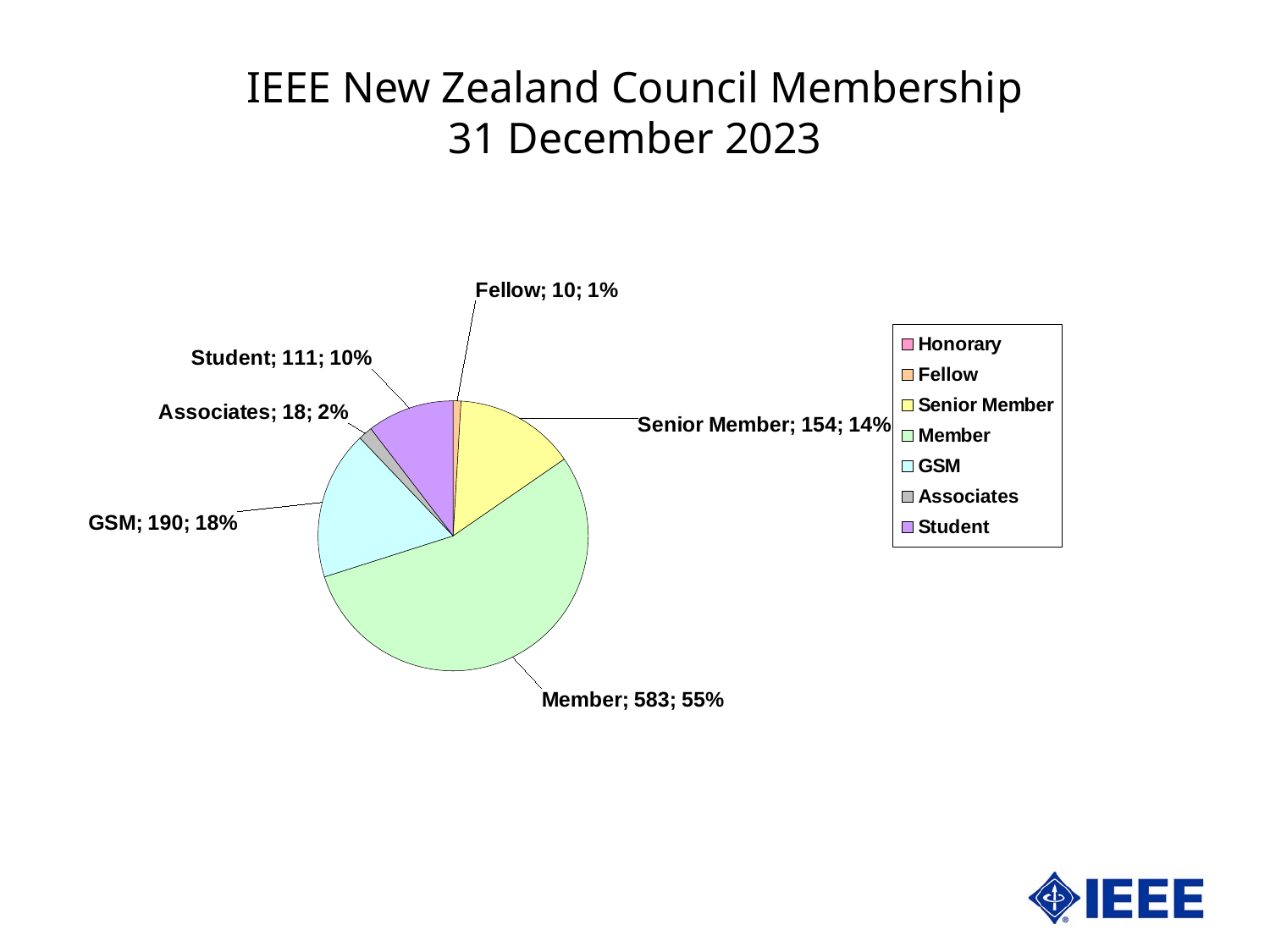
What is the value for Fellow? 10 Which labelled category has the smallest slice of the pie? Fellow What is the value for GSM? 190 What share of the pie does the Student slice represent? 10% Which is larger, the Senior Member value or the Student value? Senior Member How many members are in the Member category? 583 Which category has the largest slice of the pie? Member What type of chart is shown on the slide? pie chart What share of the pie does the Member slice represent? 55% What is the value for Senior Member? 154 How many entries does the legend list? 7 What is the difference between the Member value and the GSM value? 393